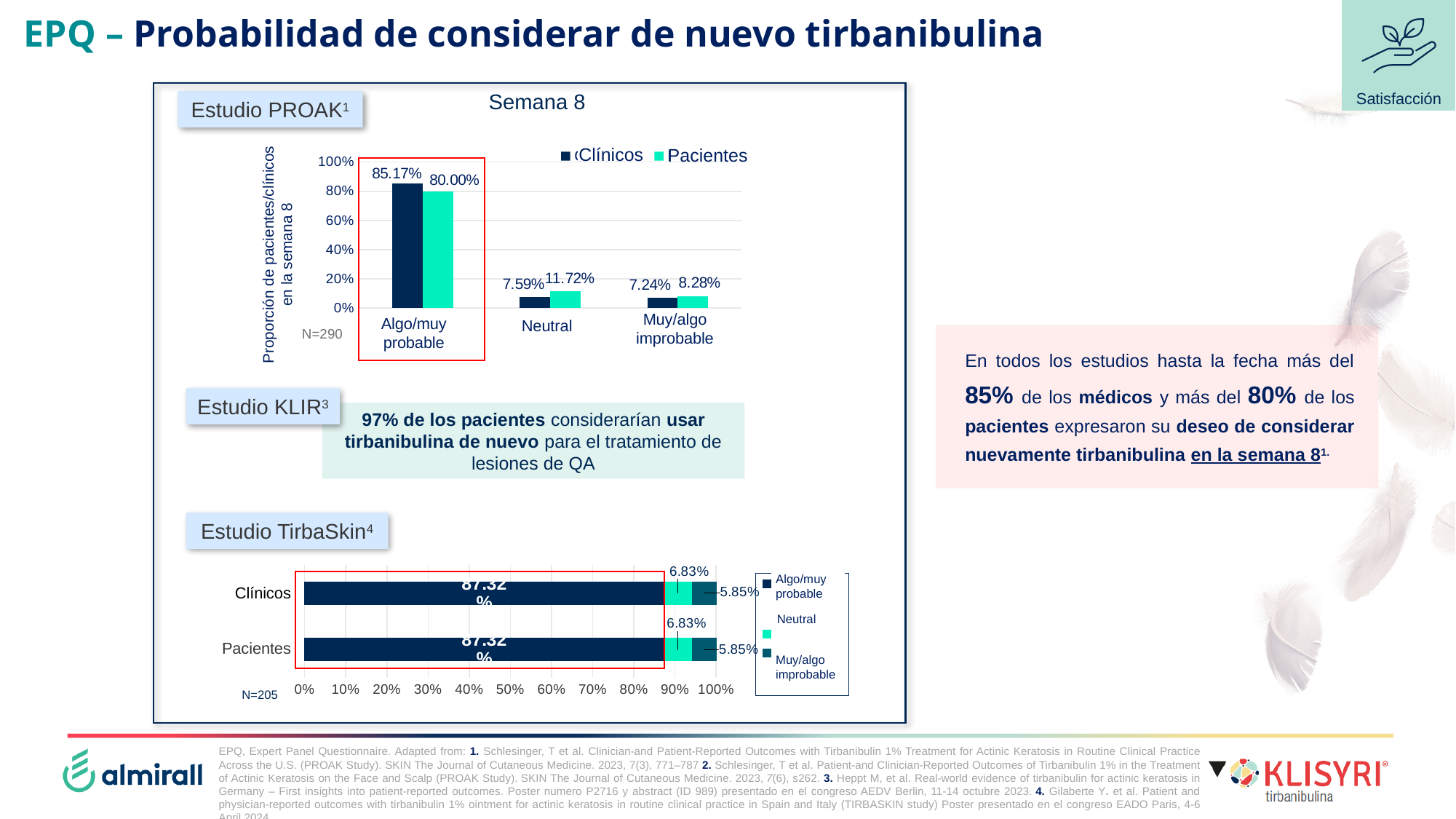
What kind of chart is the Estudio TirbaSkin chart? Stacked horizontal bar chart In the Estudio TirbaSkin chart, what is the Algo/muy probable value for Clínicos? 87.32% In the Estudio PROAK chart (Semana 8), which category has the highest value for Pacientes? Algo/muy probable In the Estudio PROAK chart (Semana 8), which is larger in the Neutral category: Clínicos or Pacientes? Pacientes In the Estudio TirbaSkin chart, what is the Muy/algo improbable value for Pacientes? 5.85% In the Estudio PROAK chart (Semana 8), what is the difference between the Clínicos and Pacientes values in the Algo/muy probable category? 5.17% In the Estudio PROAK chart (Semana 8), what is the value for Clínicos in the Muy/algo improbable category? 7.24% In the Estudio PROAK chart (Semana 8), what is the value for Clínicos in the Algo/muy probable category? 85.17% In the Estudio PROAK chart (Semana 8), how many categories are shown on the x axis? 3 In the Estudio PROAK chart (Semana 8), which category has the lowest value for Clínicos? Muy/algo improbable In the Estudio PROAK chart (Semana 8), what is the value for Pacientes in the Neutral category? 11.72% In the Estudio PROAK chart (Semana 8), how many series does the legend list? 2